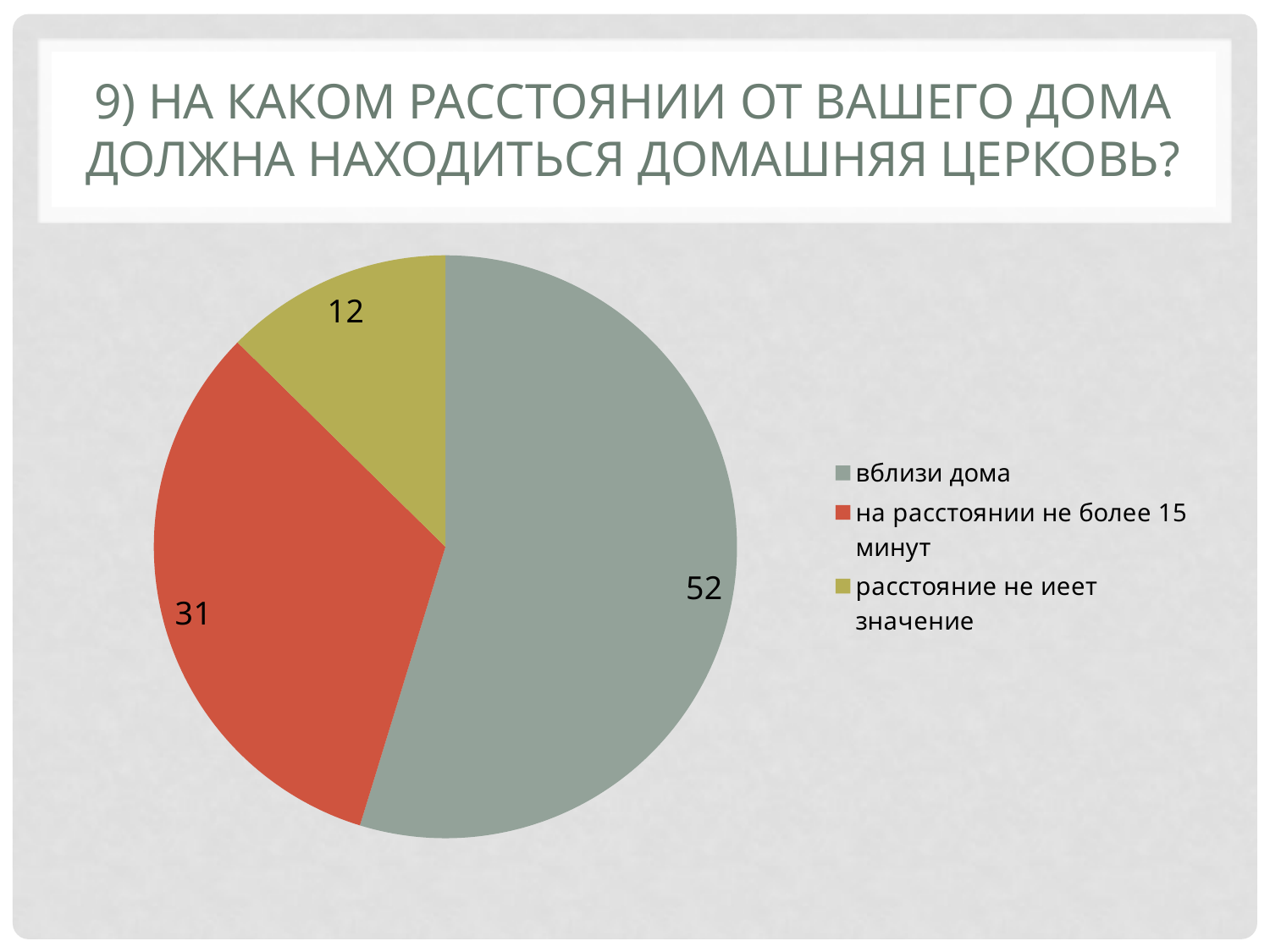
What colour is the slice for "вблизи дома"? grey-green What is the value for the slice "на расстоянии не более 15 минут"? 31 How many slices does the pie chart have? 3 What is the value for the slice "расстояние не иеет значение"? 12 What is the difference between the values for "вблизи дома" and "на расстоянии не более 15 минут"? 21 Which category has the largest slice of the pie? вблизи дома Which is larger: the value for "на расстоянии не более 15 минут" or the value for "расстояние не иеет значение"? на расстоянии не более 15 минут Which category has the smallest slice of the pie? расстояние не иеет значение What kind of chart is shown on the slide? pie chart What is the value for the slice "вблизи дома"? 52 What is the difference between the values for "на расстоянии не более 15 минут" and "расстояние не иеет значение"? 19 What is the sum of all the values shown in the pie chart? 95